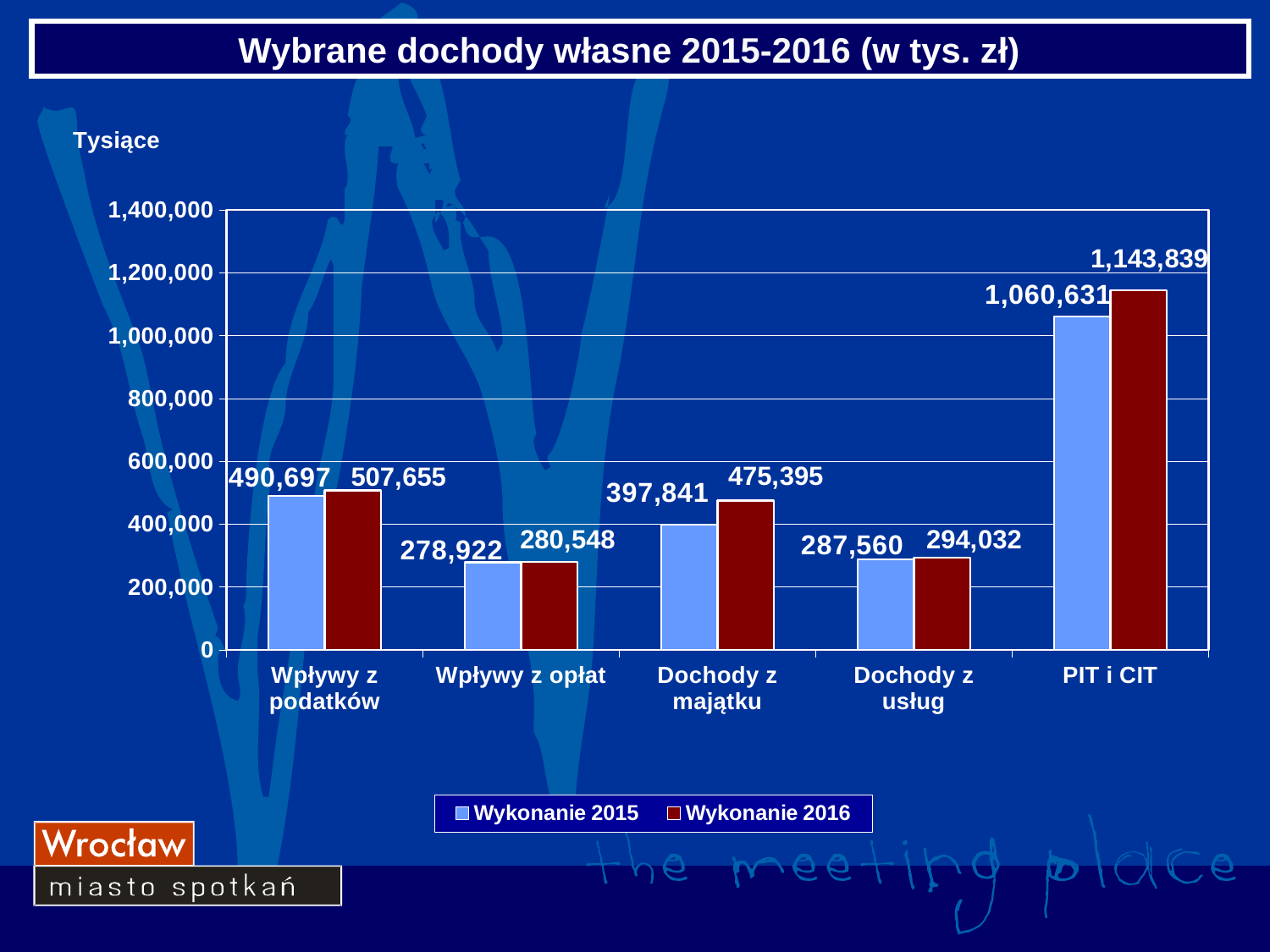
How many categories are shown on the x axis? 5 What is the Wykonanie 2015 value for Dochody z usług? 287,560 Which is larger: the Wykonanie 2015 value for Wpływy z podatków or the Wykonanie 2016 value for Dochody z majątku? Wykonanie 2015 value for Wpływy z podatków What is the Wykonanie 2016 value for Dochody z majątku? 475,395 Which category has the highest Wykonanie 2016 value? PIT i CIT What is the Wykonanie 2016 value for PIT i CIT? 1,143,839 What is the Wykonanie 2015 value for Wpływy z podatków? 490,697 How many series does the legend list? 2 Which category has the lowest Wykonanie 2015 value? Wpływy z opłat What kind of chart is shown on the slide? Bar chart What is the difference between the Wykonanie 2016 and Wykonanie 2015 values for Dochody z majątku? 77,554 What is the difference between the Wykonanie 2016 and Wykonanie 2015 values for PIT i CIT? 83,208